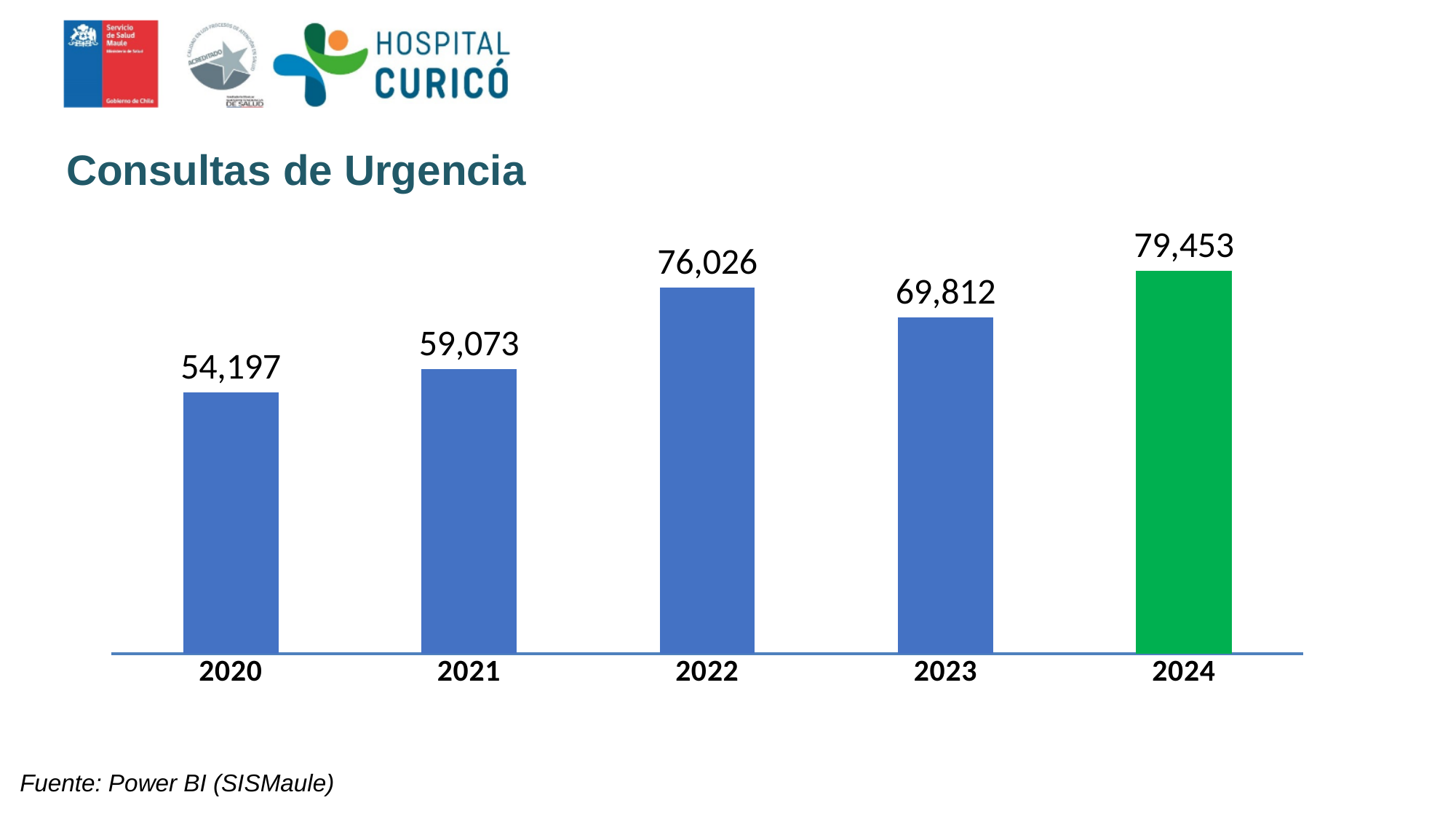
Which is larger, the value for 2022 or the value for 2023? 2022 Which year has the lowest value? 2020 What is the value for 2022? 76,026 What kind of chart is shown on the slide? Bar chart What is the difference between the values for 2021 and 2020? 4,876 Which year has the highest value? 2024 How many years are shown on the chart? 5 What is the value for 2023? 69,812 What is the difference between the values for 2024 and 2023? 9,641 What is the value for 2020? 54,197 What is the value for 2024? 79,453 What is the title of the chart? Consultas de Urgencia